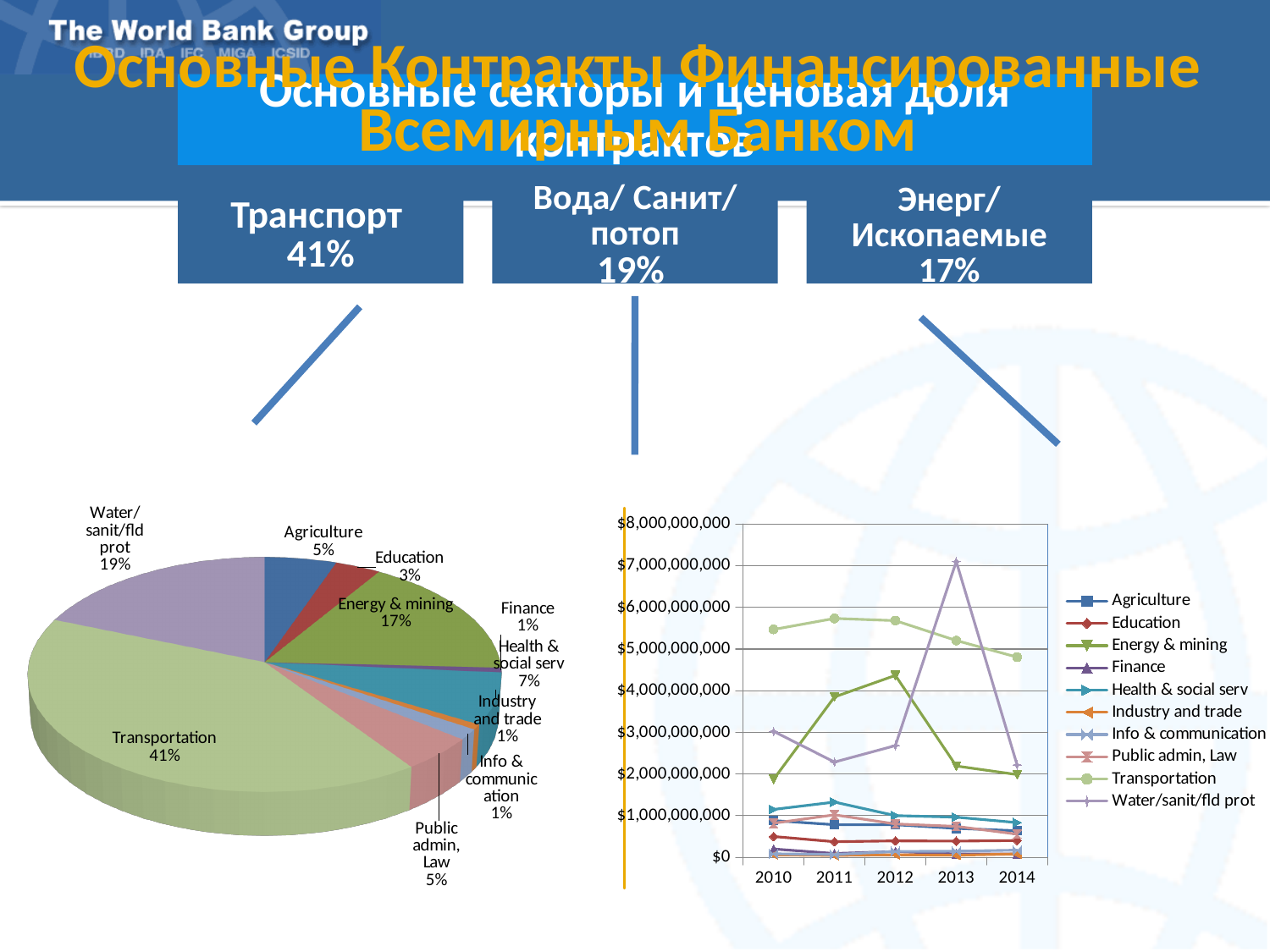
On the pie chart on the left, what share does Energy & mining have? 17% On the pie chart on the left, how many sectors are shown? 10 On the line chart on the right, how many series does the legend list? 10 On the pie chart on the left, which is larger: Health & social serv or Agriculture? Health & social serv On the line chart on the right, is the value for Energy & mining in 2012 greater or less than $4,000,000,000? greater What kind of chart is the chart on the left of the slide? Pie chart On the pie chart on the left, which sector has the largest share? Transportation On the pie chart on the left, what is the difference in percentage points between Water/sanit/fld prot and Education? 16 On the line chart on the right, is the value for Transportation in 2010 greater or less than $5,000,000,000? greater What kind of chart is the chart on the right of the slide? Line chart On the pie chart on the left, what share does Transportation have? 41% On the line chart on the right, which series has the highest value in 2013? Water/sanit/fld prot